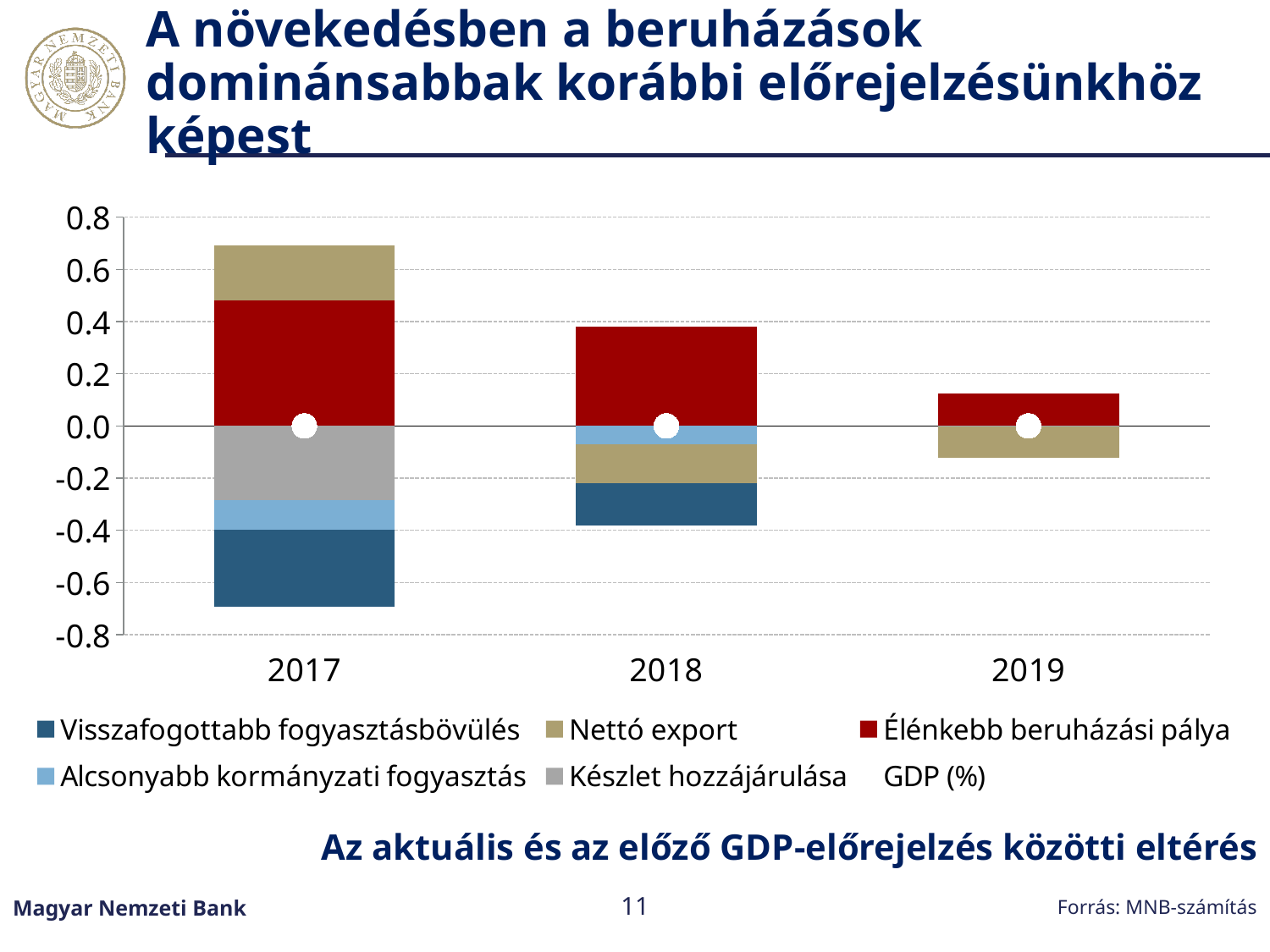
Is the top of the stacked bar for 2018 greater or less than 0.2? greater Does the Élénkebb beruházási pálya segment rise or fall from 2017 to 2019? fall Is the Élénkebb beruházási pálya segment for 2019 greater or less than 0.2? less In which year does the positive part of the stacked bar reach the highest value? 2017 Is the top of the stacked bar for 2017 greater or less than 0.6? greater How many years are shown on the x axis of the chart? 3 What kind of chart is shown on the slide? Stacked bar chart Is the Élénkebb beruházási pálya segment larger in 2017 or in 2019? 2017 What colour represents Élénkebb beruházási pálya in the chart? Red How many entries does the chart legend list? 6